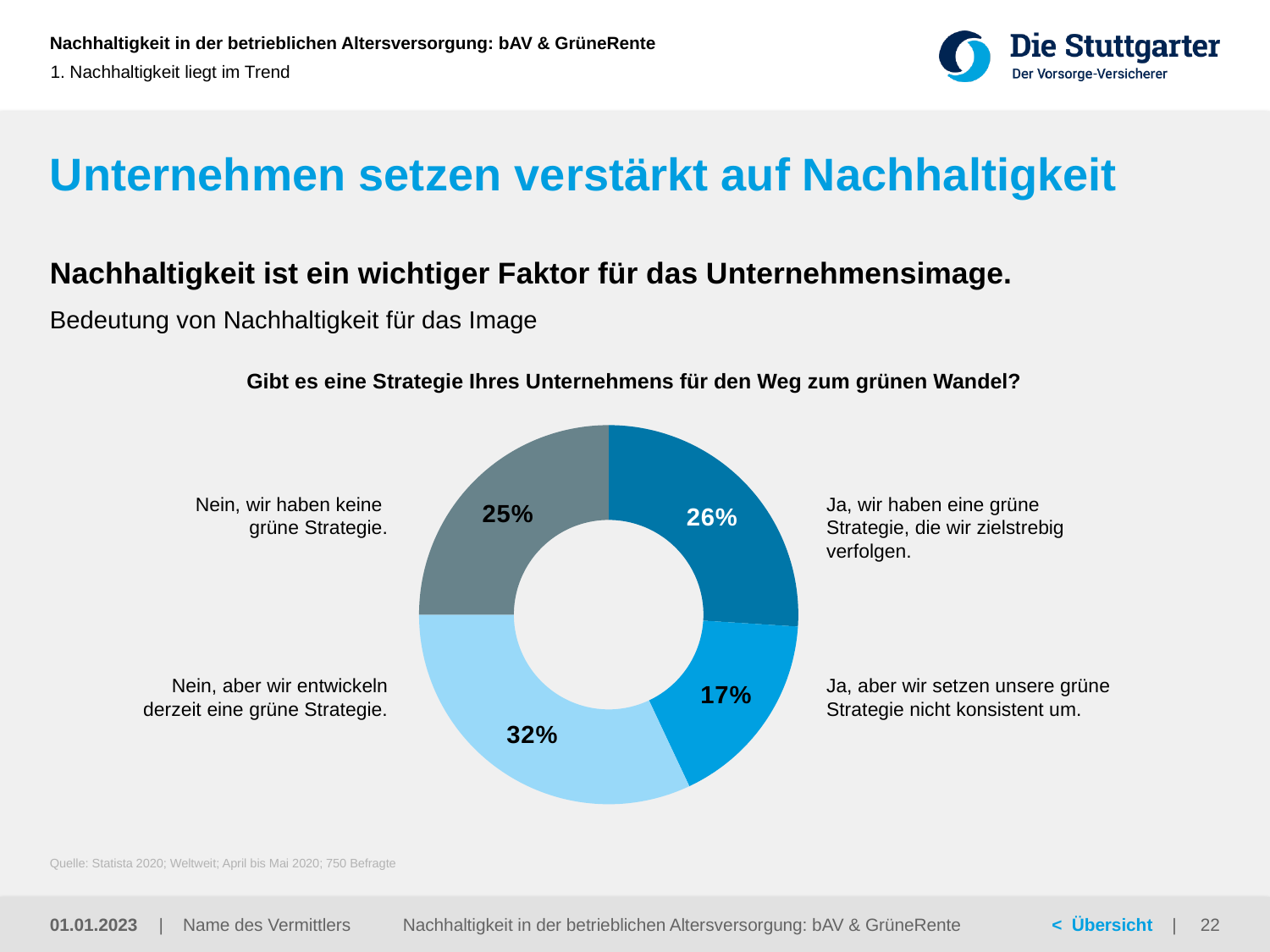
What question does the chart title ask? Gibt es eine Strategie Ihres Unternehmens für den Weg zum grünen Wandel? What percentage of respondents said "Nein, wir haben keine grüne Strategie."? 25% What percentage of respondents said "Nein, aber wir entwickeln derzeit eine grüne Strategie."? 32% Which answer category has the smallest share in the chart? Ja, aber wir setzen unsere grüne Strategie nicht konsistent um. How many answer categories are shown in the chart? 4 Which share is larger: "Ja, wir haben eine grüne Strategie, die wir zielstrebig verfolgen." or "Nein, wir haben keine grüne Strategie."? Ja, wir haben eine grüne Strategie, die wir zielstrebig verfolgen. Which answer category has the largest share in the chart? Nein, aber wir entwickeln derzeit eine grüne Strategie. What is the difference in percentage points between "Nein, aber wir entwickeln derzeit eine grüne Strategie." and "Ja, aber wir setzen unsere grüne Strategie nicht konsistent um."? 15 percentage points What kind of chart is shown on the slide? Doughnut chart What percentage of respondents said "Ja, wir haben eine grüne Strategie, die wir zielstrebig verfolgen."? 26% What percentage of respondents said "Ja, aber wir setzen unsere grüne Strategie nicht konsistent um."? 17% What is the combined share of the two "Ja" answers? 43%